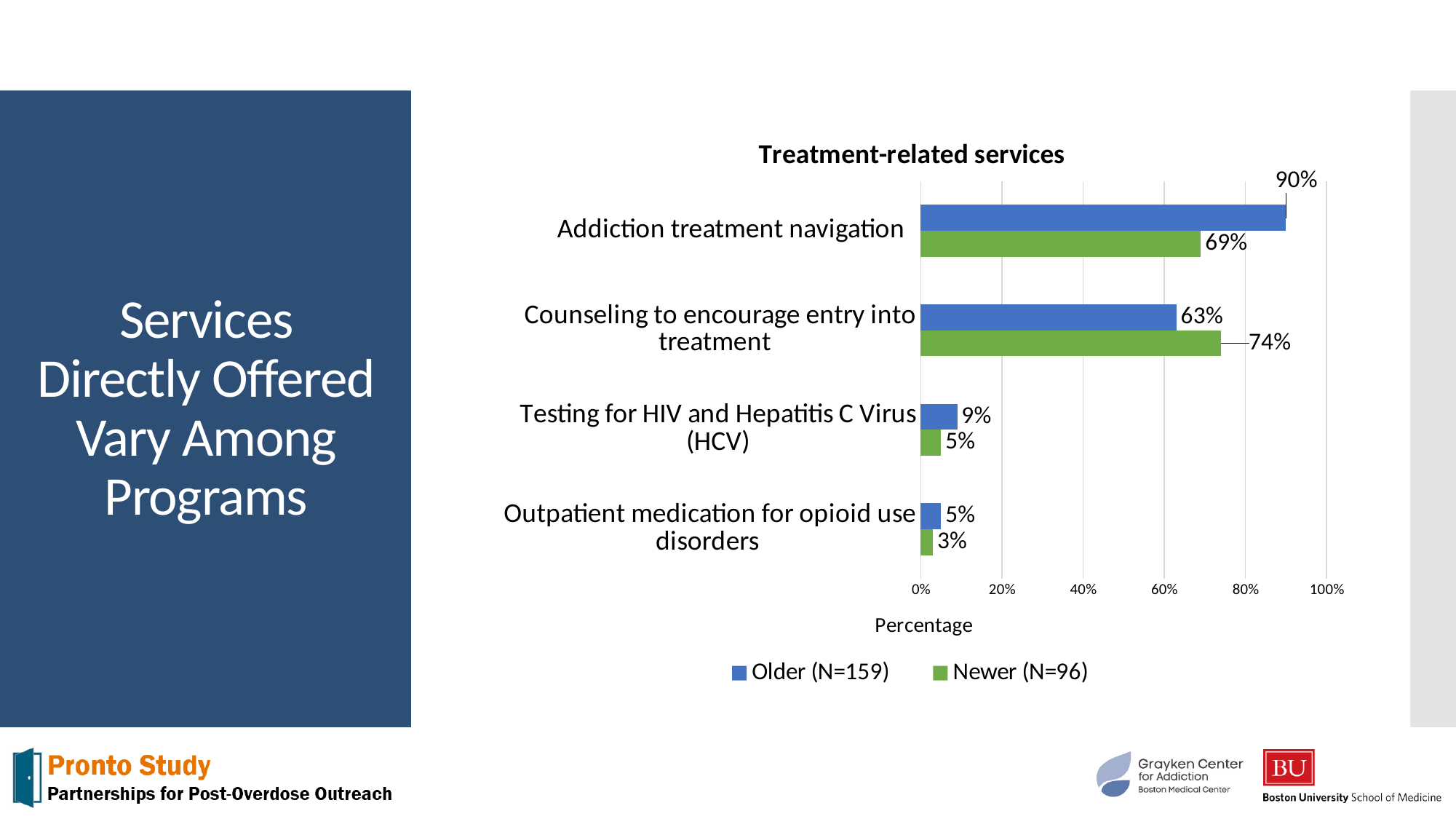
What is the difference between Older (N=159) and Newer (N=96) programs for Addiction treatment navigation? 21% How many services are shown on the chart? 4 What is the title of the chart? Treatment-related services What kind of chart is shown on the slide? bar chart Which service has the highest value for Older (N=159) programs? Addiction treatment navigation What percentage of Older (N=159) programs offer Addiction treatment navigation? 90% For Counseling to encourage entry into treatment, which group has the larger value, Older (N=159) or Newer (N=96)? Newer (N=96) What is the value for Newer (N=96) programs for Testing for HIV and Hepatitis C Virus (HCV)? 5% Is the value for Older (N=159) programs for Counseling to encourage entry into treatment greater or less than 80%? less How many series does the legend list? 2 Which service has the lowest value for Newer (N=96) programs? Outpatient medication for opioid use disorders What percentage of Newer (N=96) programs offer Counseling to encourage entry into treatment? 74%